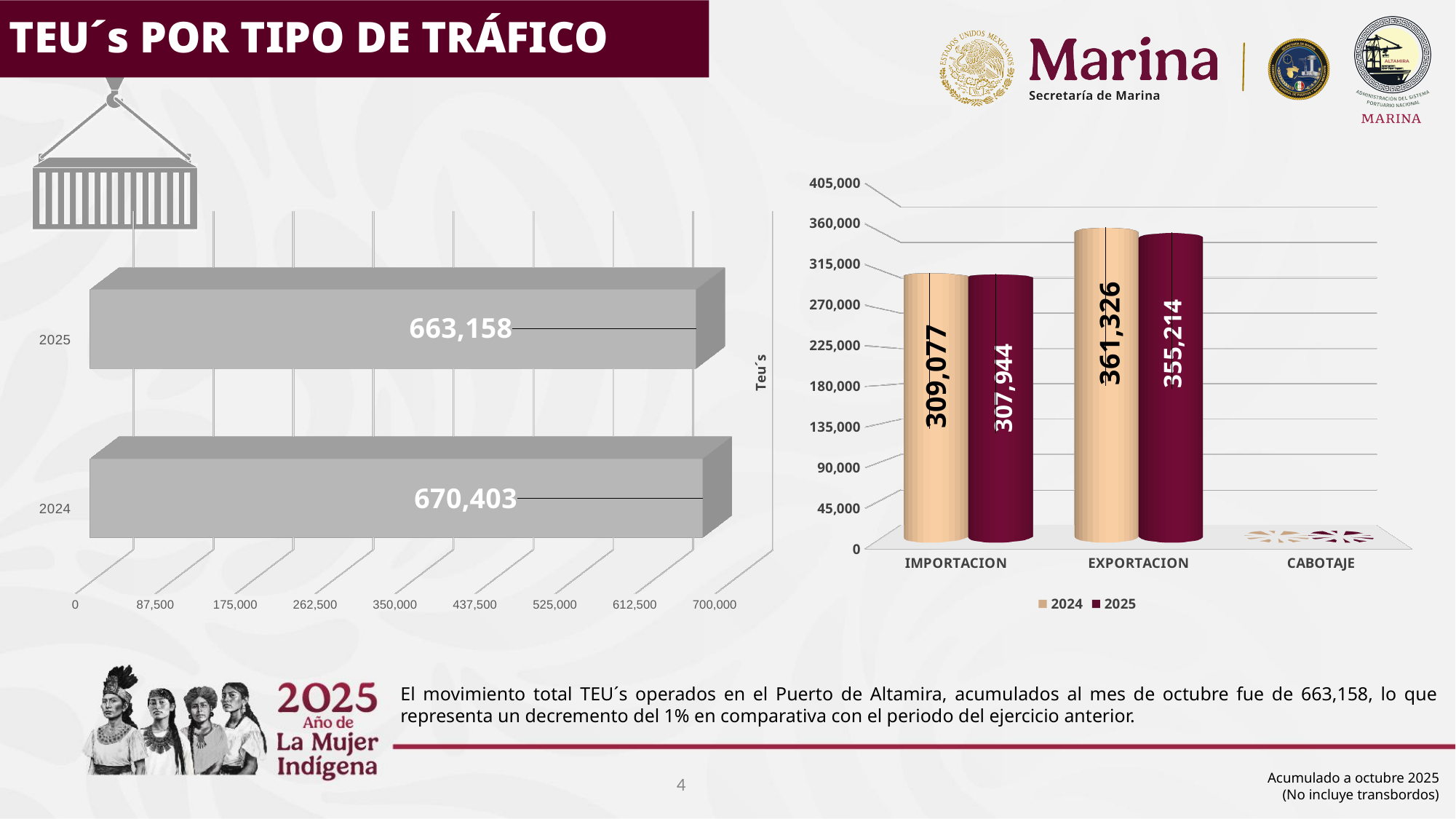
In the left chart, which year has the larger value, 2024 or 2025? 2024 In the right chart, which category has the lowest values? CABOTAJE In the right chart, what is the difference between the 2024 and 2025 values for EXPORTACION? 6,112 In the right chart, how many series does the legend list? 2 In the right chart, is the 2025 value for IMPORTACION greater or less than 315,000? less In the right chart, what is the 2024 value for IMPORTACION? 309,077 In the right chart, what is the 2025 value for EXPORTACION? 355,214 In the left chart, what is the value for 2025? 663,158 What kind of chart is the left chart? Bar chart In the left chart, what is the difference between the 2024 and 2025 values? 7,245 In the left chart, what is the value for 2024? 670,403 In the right chart, how many categories are shown on the x axis? 3